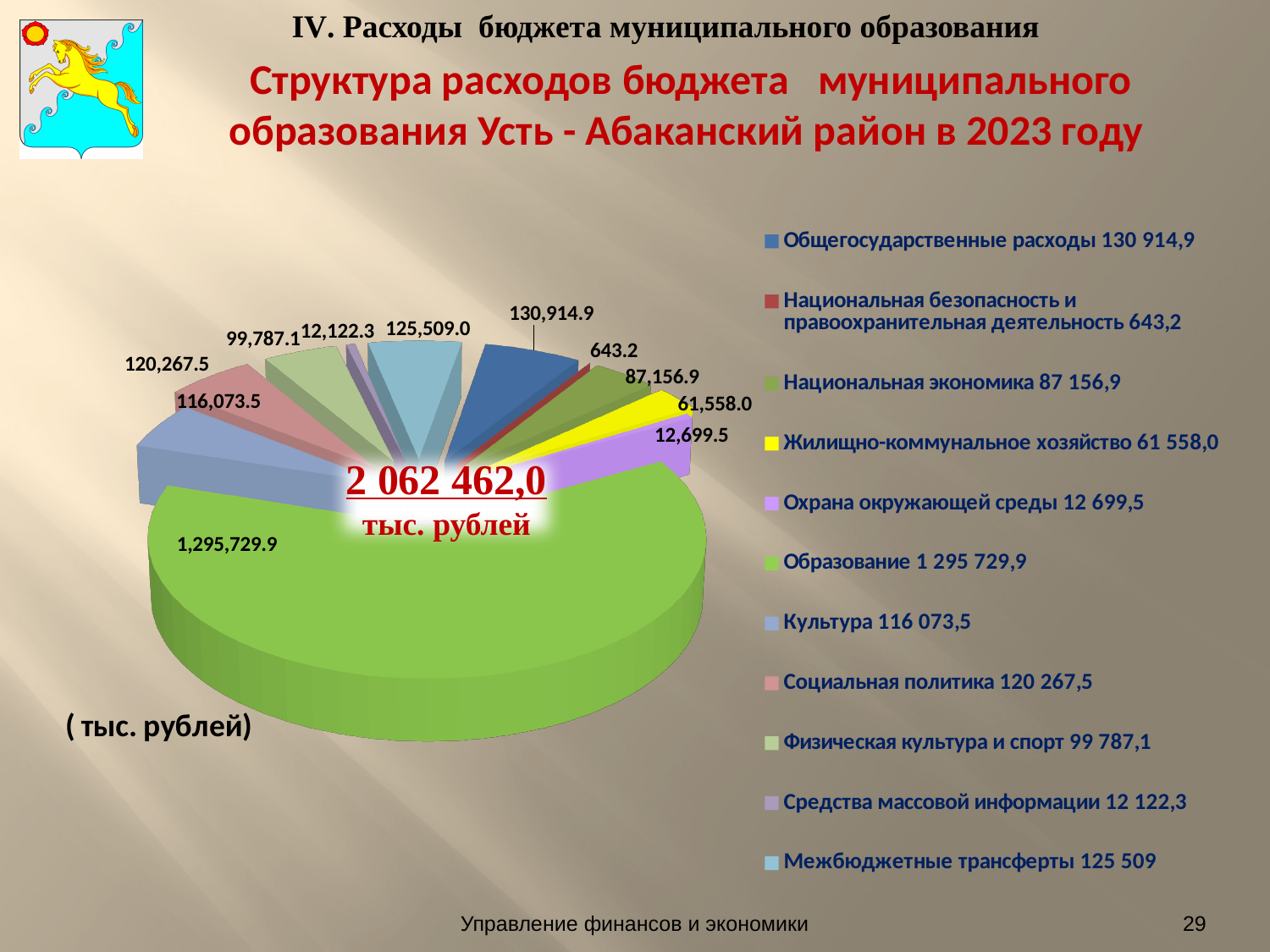
What is the difference between Общегосударственные расходы and Межбюджетные трансферты? 5,405.9 What kind of chart is shown on the slide? pie chart What is the value for Жилищно-коммунальное хозяйство? 61,558.0 What is the value for Межбюджетные трансферты? 125,509.0 What total amount is printed in the centre of the pie chart? 2 062 462,0 тыс. рублей Which category has the largest share of the pie? Образование What is the value for Образование? 1,295,729.9 What is the difference between Охрана окружающей среды and Средства массовой информации? 577.2 How many categories (slices) does the pie chart have? 11 What is the value for Общегосударственные расходы? 130,914.9 Which category has the smallest value? Национальная безопасность и правоохранительная деятельность Which is larger, Культура or Социальная политика? Социальная политика